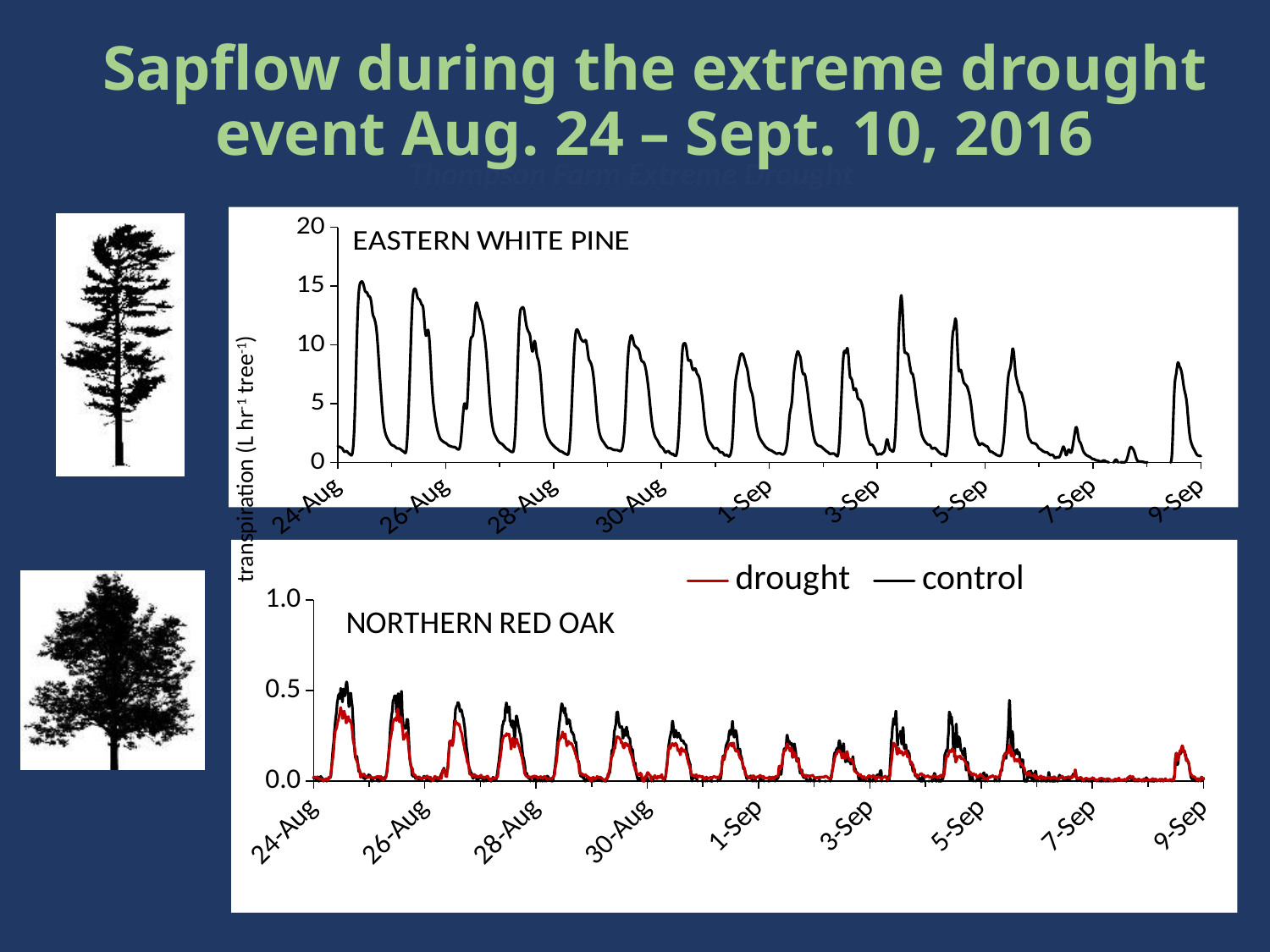
What kind of chart is the NORTHERN RED OAK chart at the bottom of the slide? line chart In the EASTERN WHITE PINE chart, do the daily peak values generally rise or fall from 24-Aug to 9-Sep? fall What kind of chart is the EASTERN WHITE PINE chart at the top of the slide? line chart In the NORTHERN RED OAK chart, which series generally reaches higher daily peaks, drought or control? control In the EASTERN WHITE PINE chart, is the peak value on 24-Aug greater or less than 10? greater How many date labels are shown on the x axis of the NORTHERN RED OAK chart? 9 What are the two series named in the legend? drought and control In the NORTHERN RED OAK chart, do the daily peak values generally rise or fall from 24-Aug to 9-Sep? fall In the EASTERN WHITE PINE chart, is the peak value on 9-Sep greater or less than 10? less How many series does the legend on the slide list? 2 In the NORTHERN RED OAK chart, is the peak drought value on 24-Aug greater or less than 0.5? less What is the label on the y axis shared by the two charts? transpiration (L hr-1 tree-1)